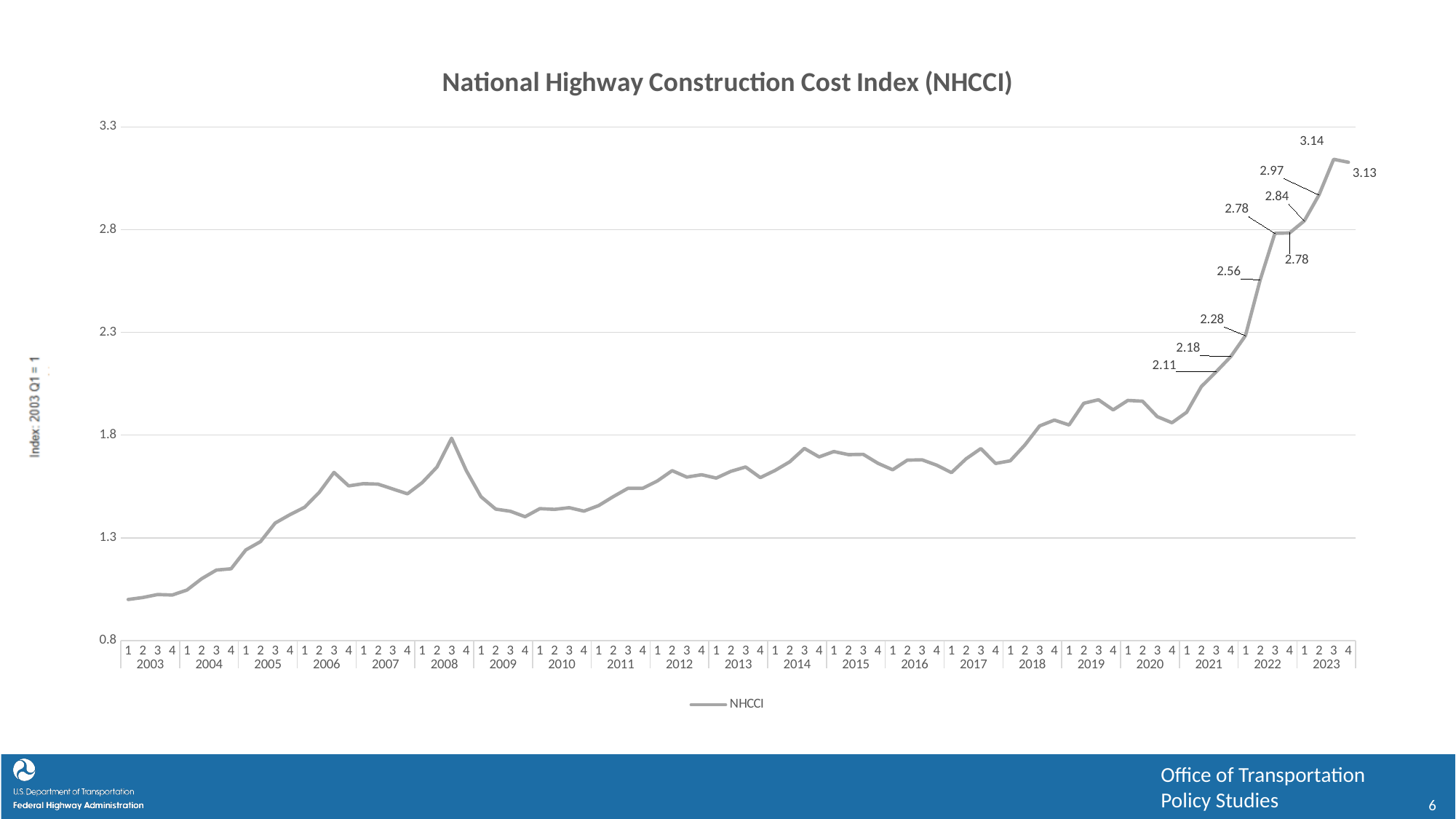
What kind of chart is shown on the slide? line chart How many series does the legend list? 1 Overall, does the NHCCI rise or fall from 2003 to 2023? rise What is the title of the chart? National Highway Construction Cost Index (NHCCI) What is the NHCCI value for quarter 3 of 2023? 3.14 What is the lowest data-labelled value on the chart? 2.11 Is the NHCCI value for quarter 4 of 2009 greater or less than 1.8? less What is the highest data-labelled value on the chart? 3.14 Is the NHCCI value for quarter 1 of 2003 greater or less than 1.3? less What is the NHCCI value for quarter 1 of 2022? 2.28 What is the difference between the labelled values 3.14 and 3.13? 0.01 What is the NHCCI value for quarter 4 of 2023? 3.13